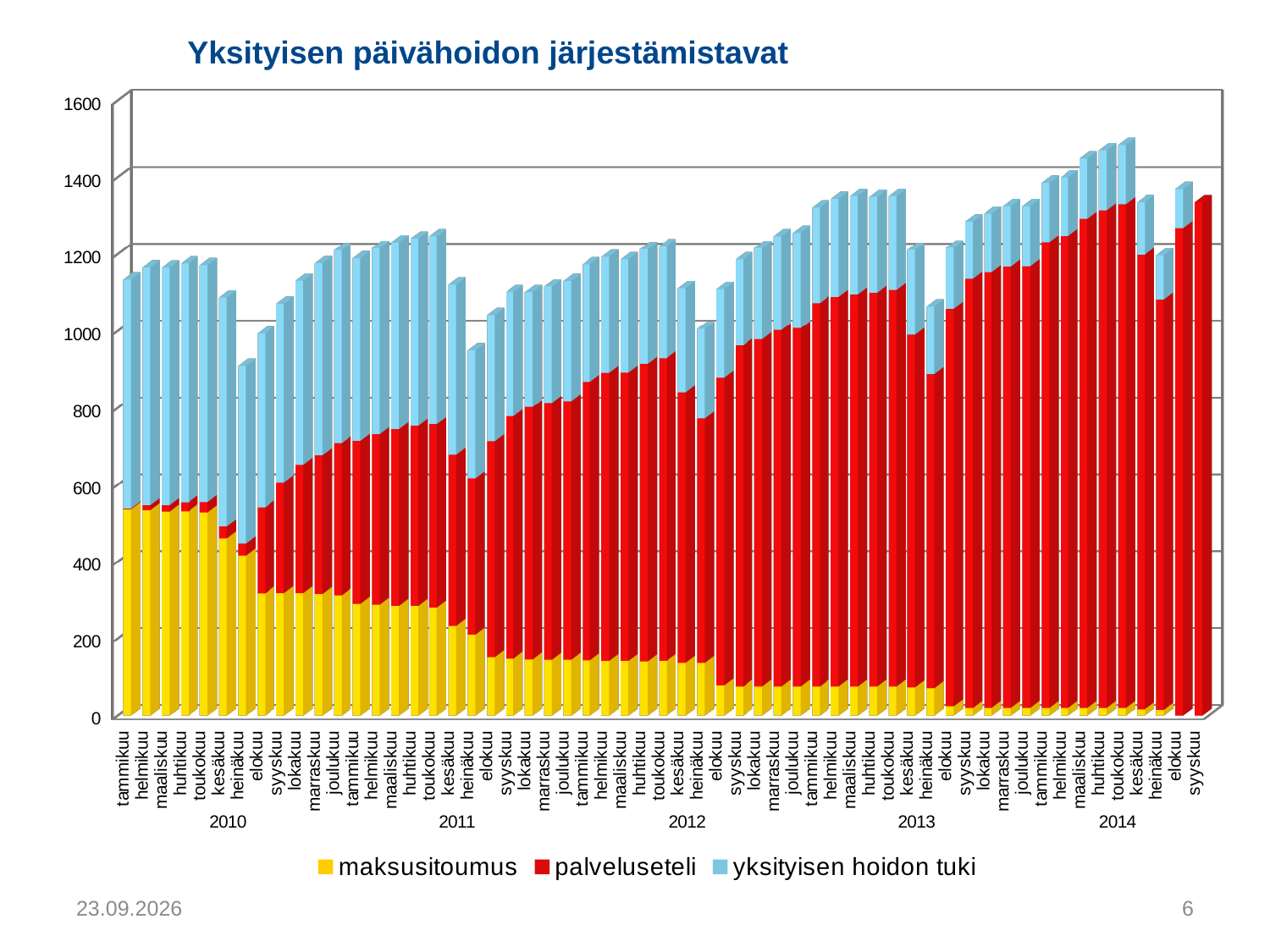
What is the title of the chart? Yksityisen päivähoidon järjestämistavat Which is larger, the palveluseteli value for syyskuu 2014 or for tammikuu 2010? syyskuu 2014 Does the maksusitoumus series rise or fall from 2010 to 2014? fall Which colour represents the palveluseteli series? red Is the maksusitoumus value for tammikuu 2010 greater or less than 400? greater How many years are labelled along the x axis? 5 Is the total value for tammikuu 2010 greater or less than 1000? greater How many series does the legend list? 3 Is the total value for heinäkuu 2013 greater or less than 1200? less What kind of chart is shown on the slide? stacked bar chart Does the palveluseteli series rise or fall from 2010 to 2014? rise